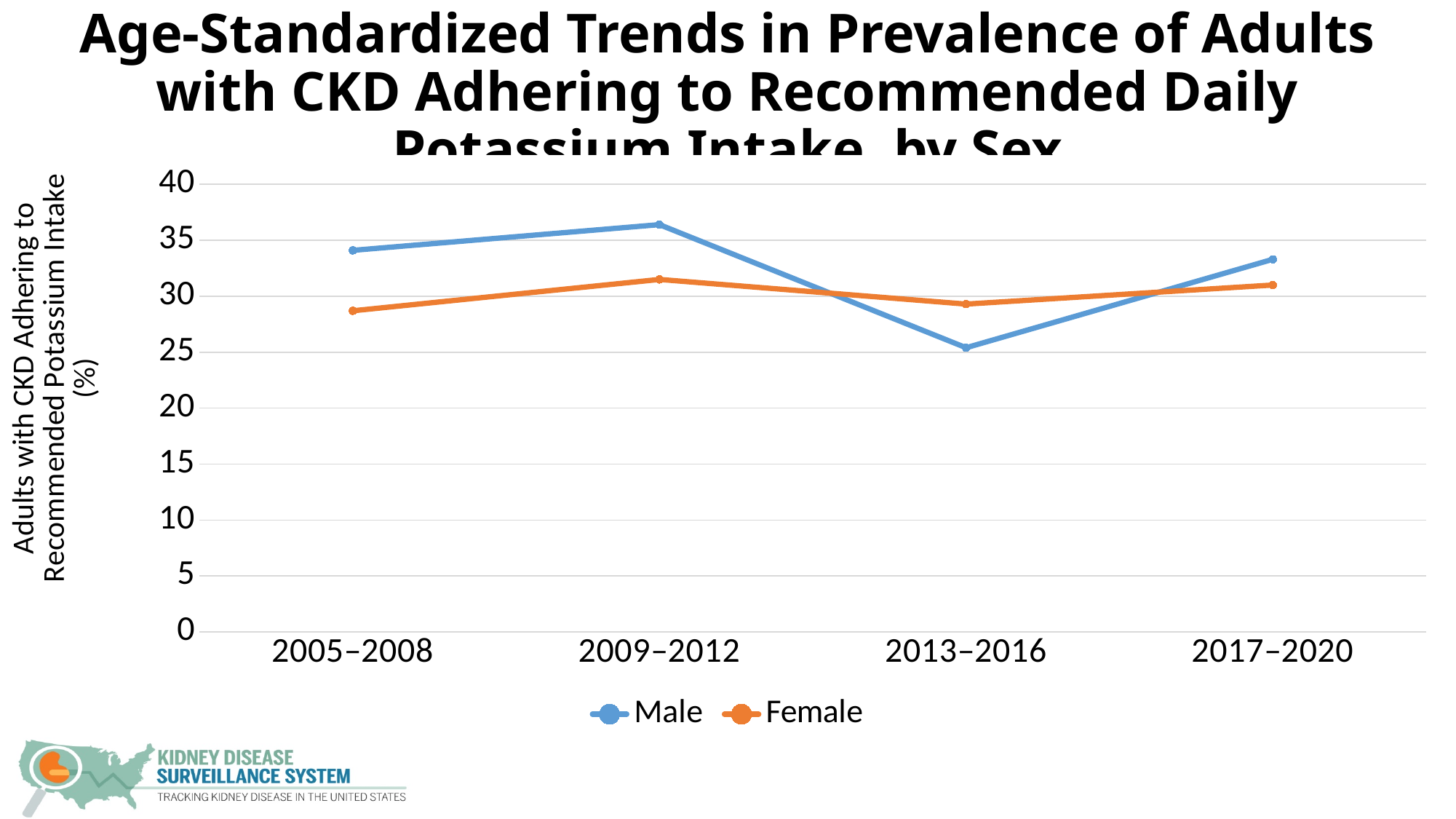
How many time periods are shown on the x axis? 4 Is the Male value for 2009–2012 greater or less than 35? greater Is the Male value for 2013–2016 greater or less than 30? less In 2013–2016, which is larger, the Male value or the Female value? Female Is the Female value for 2005–2008 greater or less than 30? less How many series does the legend list? 2 In which period is the Male value highest? 2009–2012 Does the Male value rise or fall from 2009–2012 to 2013–2016? fall In 2005–2008, which is larger, the Male value or the Female value? Male What kind of chart is shown on the slide? line chart In which period is the Male value lowest? 2013–2016 Which colour represents the Female series in the legend? orange